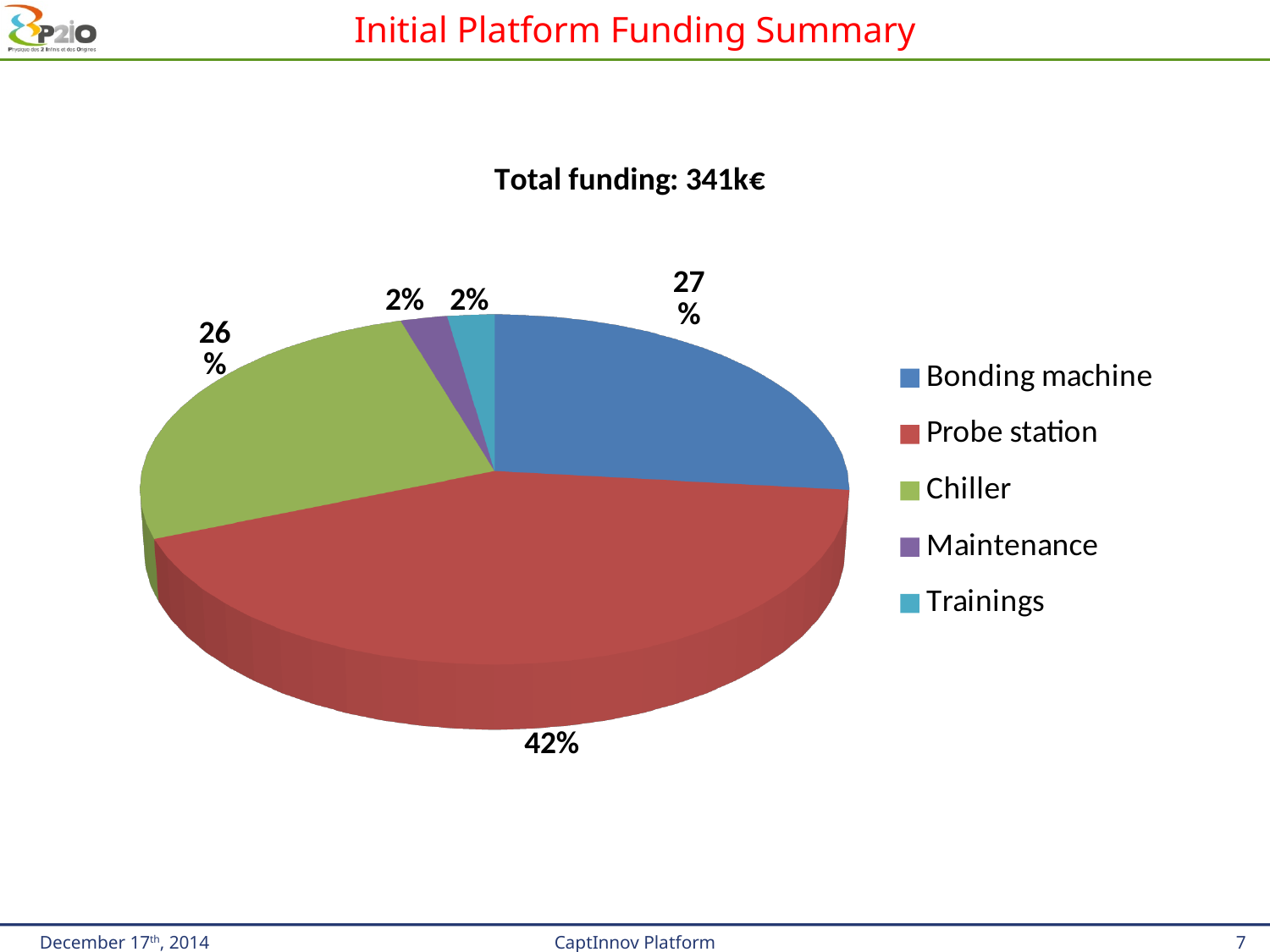
What share of the pie does Trainings represent? 2% What is the difference in percentage points between the Probe station slice and the Chiller slice? 16 What is the title shown above the pie chart? Total funding: 341k€ Which colour represents Chiller in the legend? Green Which category has the largest slice of the pie? Probe station What share of the pie does Chiller represent? 26% What share of the pie does Maintenance represent? 2% How many categories does the pie chart show? 5 Which is larger, the Bonding machine slice or the Chiller slice? Bonding machine What kind of chart is shown on the slide? Pie chart